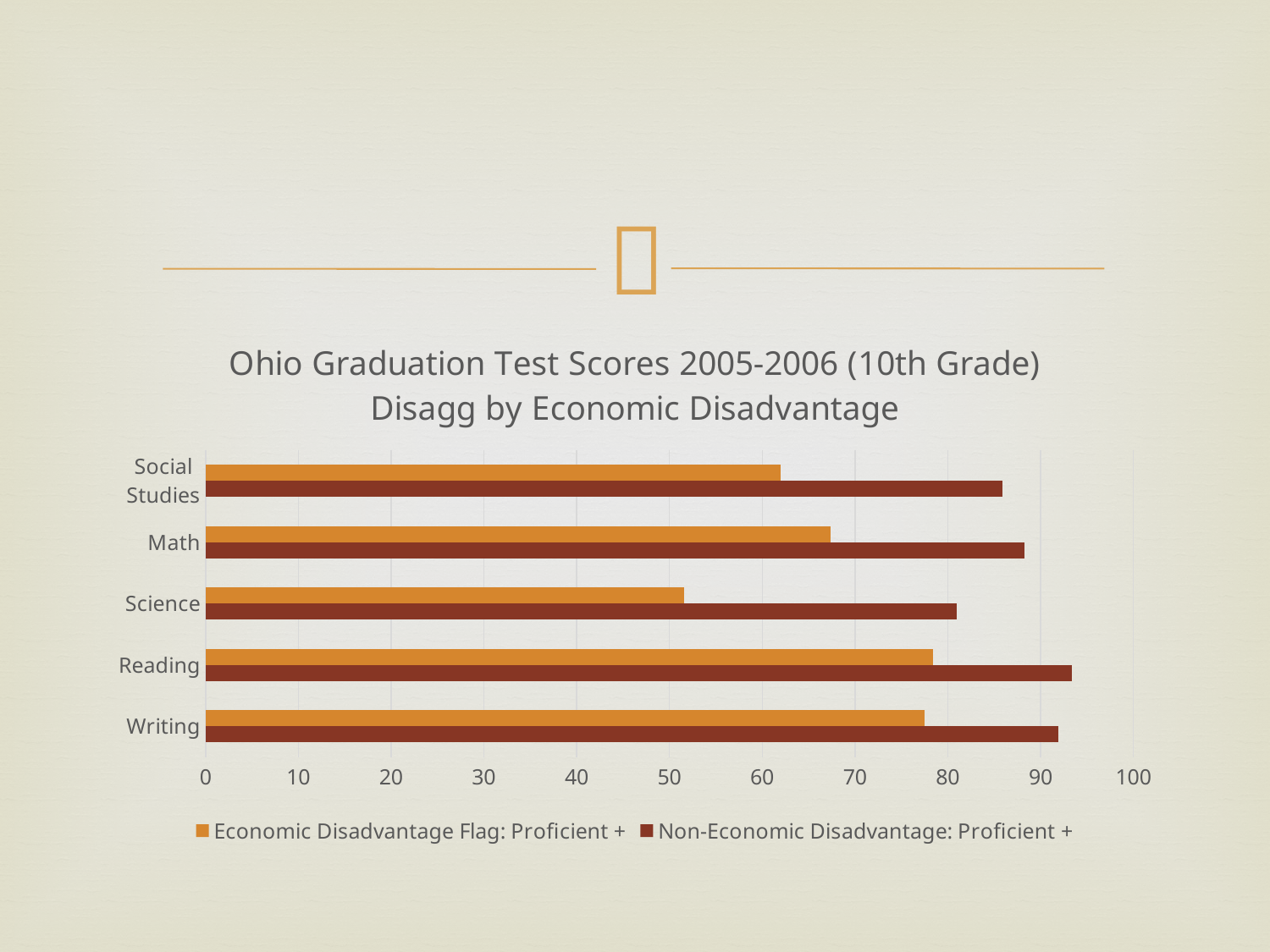
What is the title of the chart? Ohio Graduation Test Scores 2005-2006 (10th Grade) Disagg by Economic Disadvantage Which subject has the lowest value for Economic Disadvantage Flag: Proficient +? Science How many series does the legend list? 2 What kind of chart is shown on the slide? bar chart Is the value for Reading in the Non-Economic Disadvantage: Proficient + series greater or less than 90? greater How many subject categories are shown on the chart? 5 Is the value for Writing in the Economic Disadvantage Flag: Proficient + series greater or less than 80? less Which series is shown in the darker red-brown colour? Non-Economic Disadvantage: Proficient + For Science, which series has the larger value, Economic Disadvantage Flag: Proficient + or Non-Economic Disadvantage: Proficient +? Non-Economic Disadvantage: Proficient + Which is larger for Economic Disadvantage Flag: Proficient +, Math or Social Studies? Math Which subject has the lowest value for Non-Economic Disadvantage: Proficient +? Science Is the value for Science in the Economic Disadvantage Flag: Proficient + series greater or less than 60? less